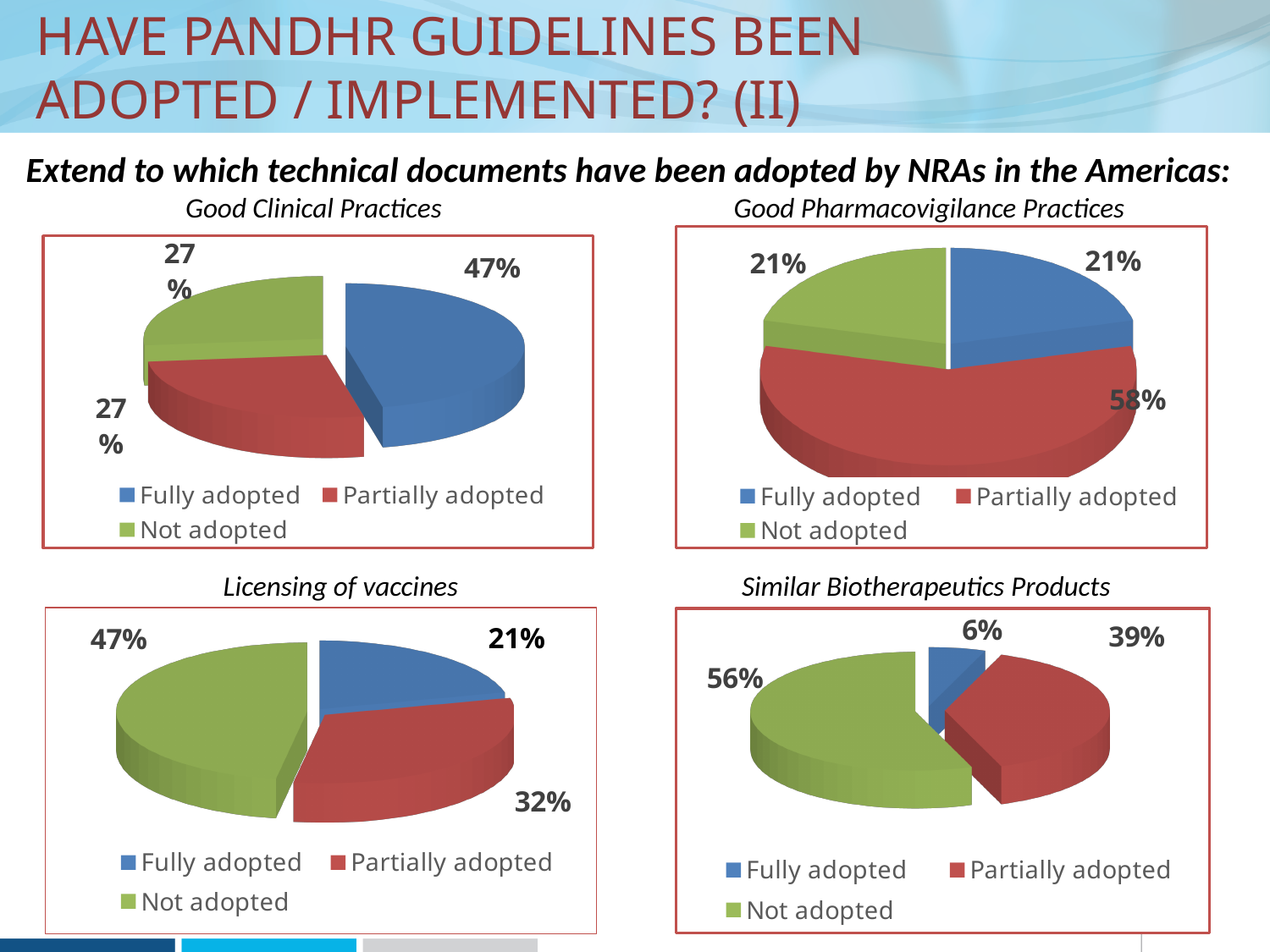
In the Good Clinical Practices chart, what share is Fully adopted? 47% In the Good Pharmacovigilance Practices chart, what share is Partially adopted? 58% How many charts are shown on the slide? 4 In the Similar Biotherapeutics Products chart, which category has the largest slice? Not adopted How many entries does the legend of the Good Clinical Practices chart list? 3 In the Licensing of vaccines chart, what share is Not adopted? 47% In the Good Pharmacovigilance Practices chart, which category has the largest slice? Partially adopted What type of chart is the Licensing of vaccines chart? Pie chart In the Similar Biotherapeutics Products chart, what share is Fully adopted? 6% In the Licensing of vaccines chart, what is the difference between the Not adopted and Partially adopted shares? 15% In the Licensing of vaccines chart, which category has the smallest slice? Fully adopted In the Similar Biotherapeutics Products chart, which is larger: Partially adopted or Fully adopted? Partially adopted